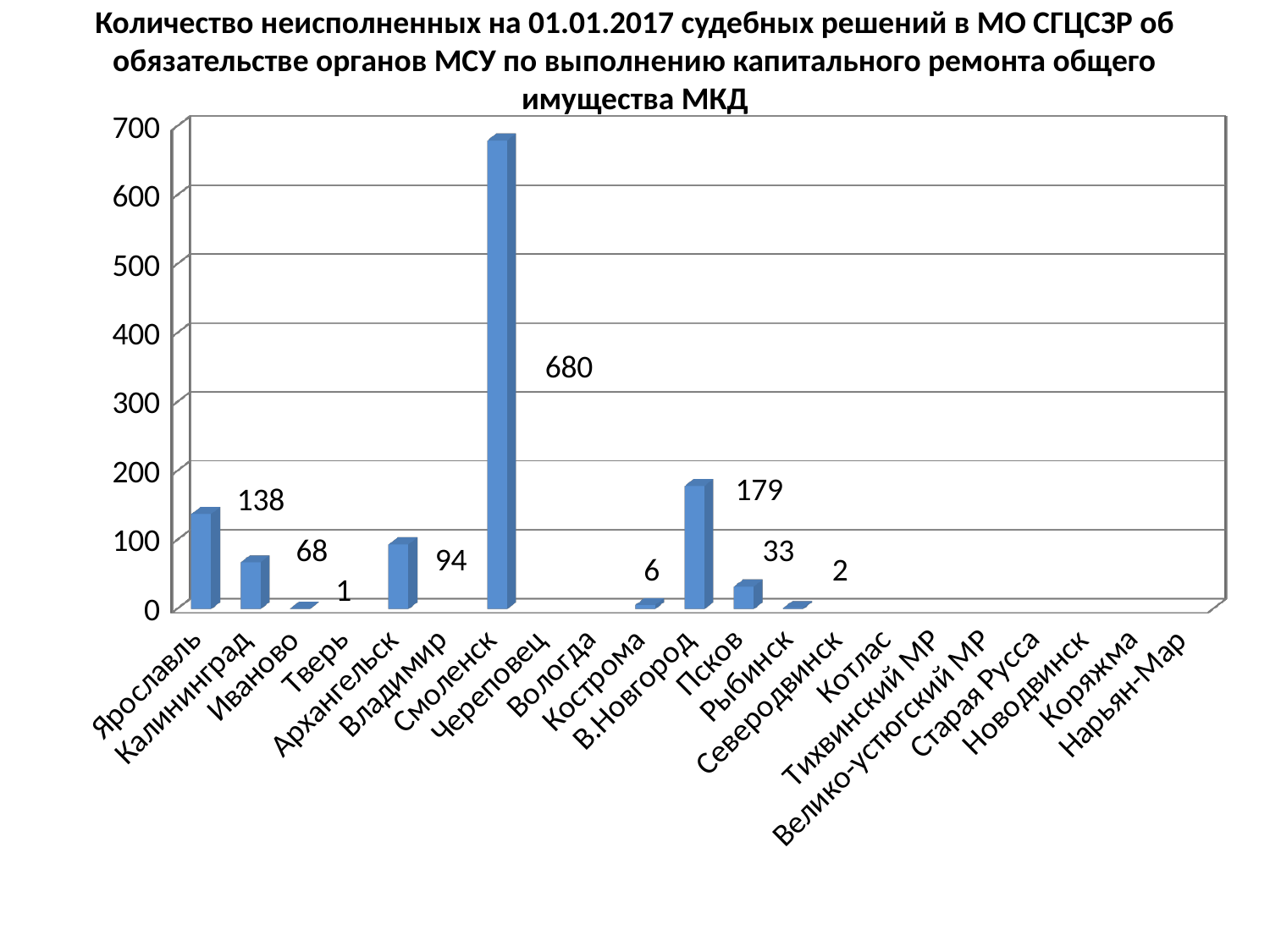
What is the value for Ярославль? 138 What is the value for Архангельск? 94 Which category has the highest value? Смоленск What is the value for Псков? 33 What kind of chart is shown on the slide? bar chart What is the value for Смоленск? 680 Which is larger, the value for Ярославль or the value for Архангельск? Ярославль What is the difference between the values for Ярославль and Калининград? 70 How many categories are shown on the x axis? 21 What is the value for В.Новгород? 179 What is the difference between the values for Смоленск and В.Новгород? 501 Is the value for Смоленск greater or less than 600? greater